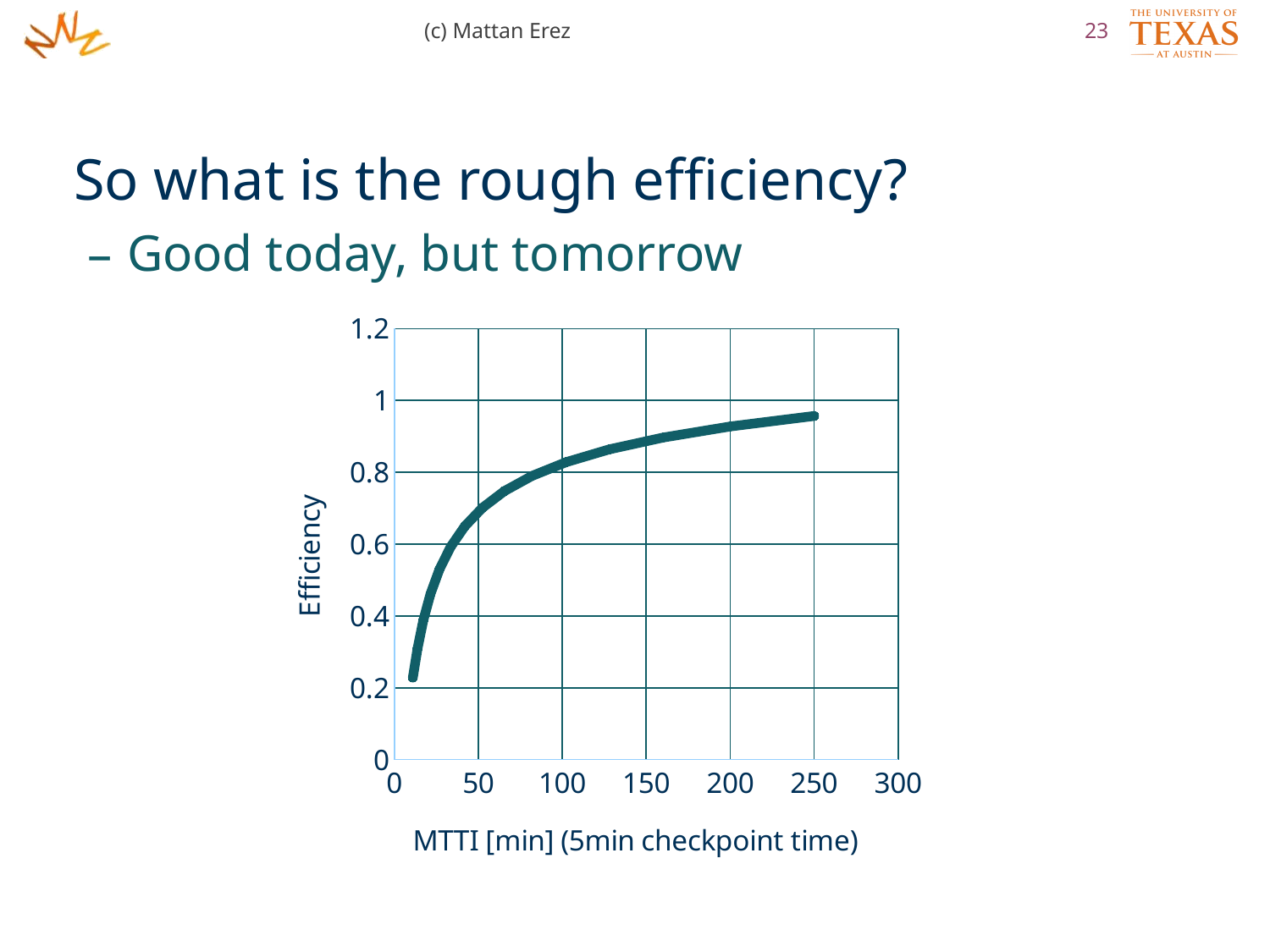
Is the efficiency at an MTTI of 100 min greater or less than 0.6? greater Is the efficiency at the lowest plotted MTTI (around 10 min) greater or less than 0.4? less What is the label of the x axis? MTTI [min] (5min checkpoint time) Does efficiency rise or fall as MTTI increases along the x axis? rise Is the efficiency at an MTTI of 150 min greater or less than 1? less What is the label of the y axis? Efficiency What kind of chart is shown on the slide? line chart Which has the higher efficiency: an MTTI of 50 min or an MTTI of 200 min? 200 min